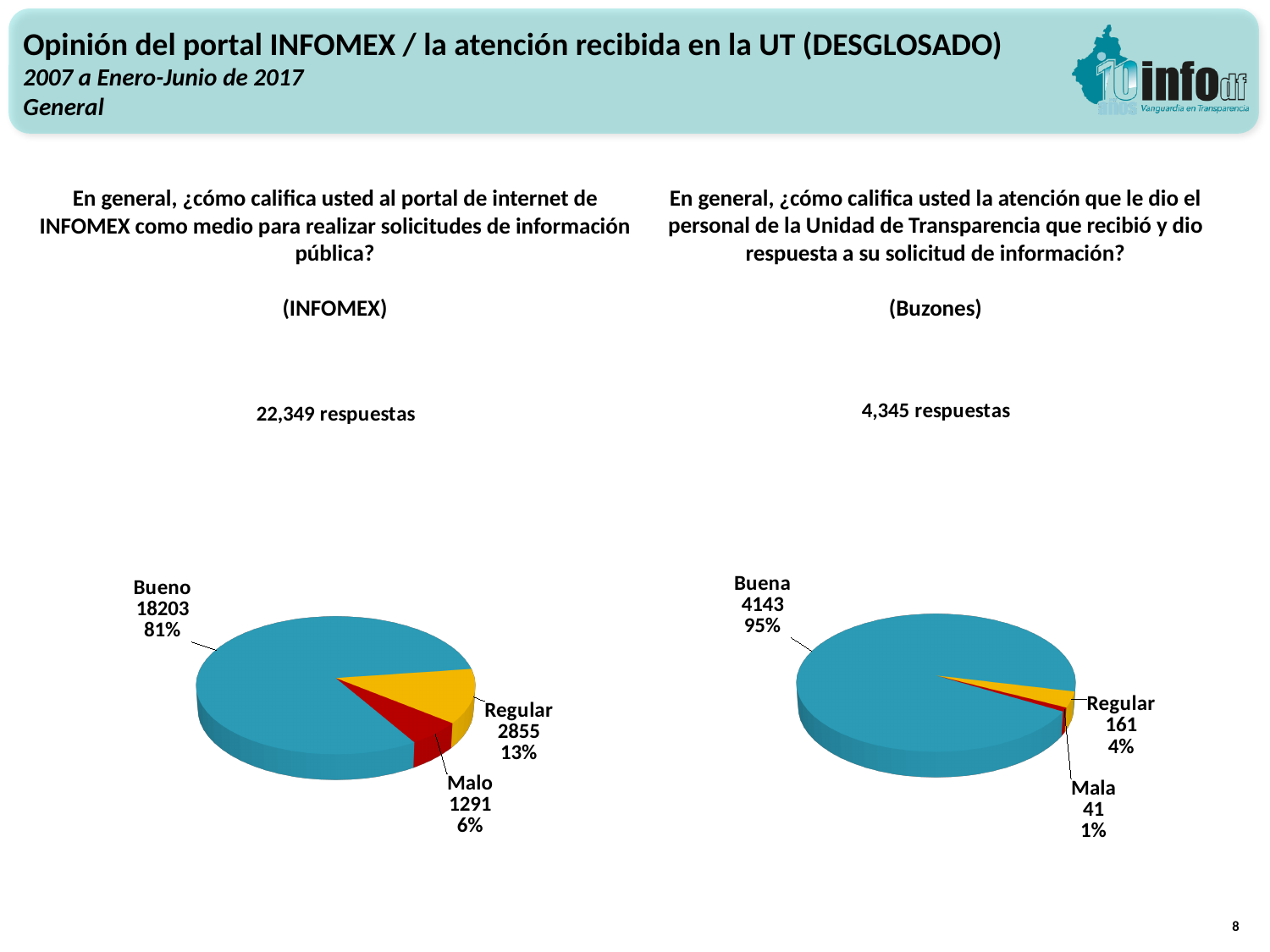
In the INFOMEX pie chart on the left, what percentage share does Regular have? 13% What type of chart is used for the Buzones data on the right? Pie chart In the Buzones pie chart on the right, what is the value for Regular? 161 In the Buzones pie chart on the right, what percentage share does Mala have? 1% In the INFOMEX pie chart on the left, what is the value for Malo? 1291 In the Buzones pie chart on the right, which category has the largest slice? Buena In the Buzones pie chart on the right, which is larger, Regular or Mala? Regular In the INFOMEX pie chart on the left, what is the difference between the Regular and Malo values? 1564 In the INFOMEX pie chart on the left, what is the value for Bueno? 18203 In the INFOMEX pie chart on the left, which category has the smallest slice? Malo How many categories does the INFOMEX pie chart on the left show? 3 In the Buzones pie chart on the right, what is the value for Buena? 4143